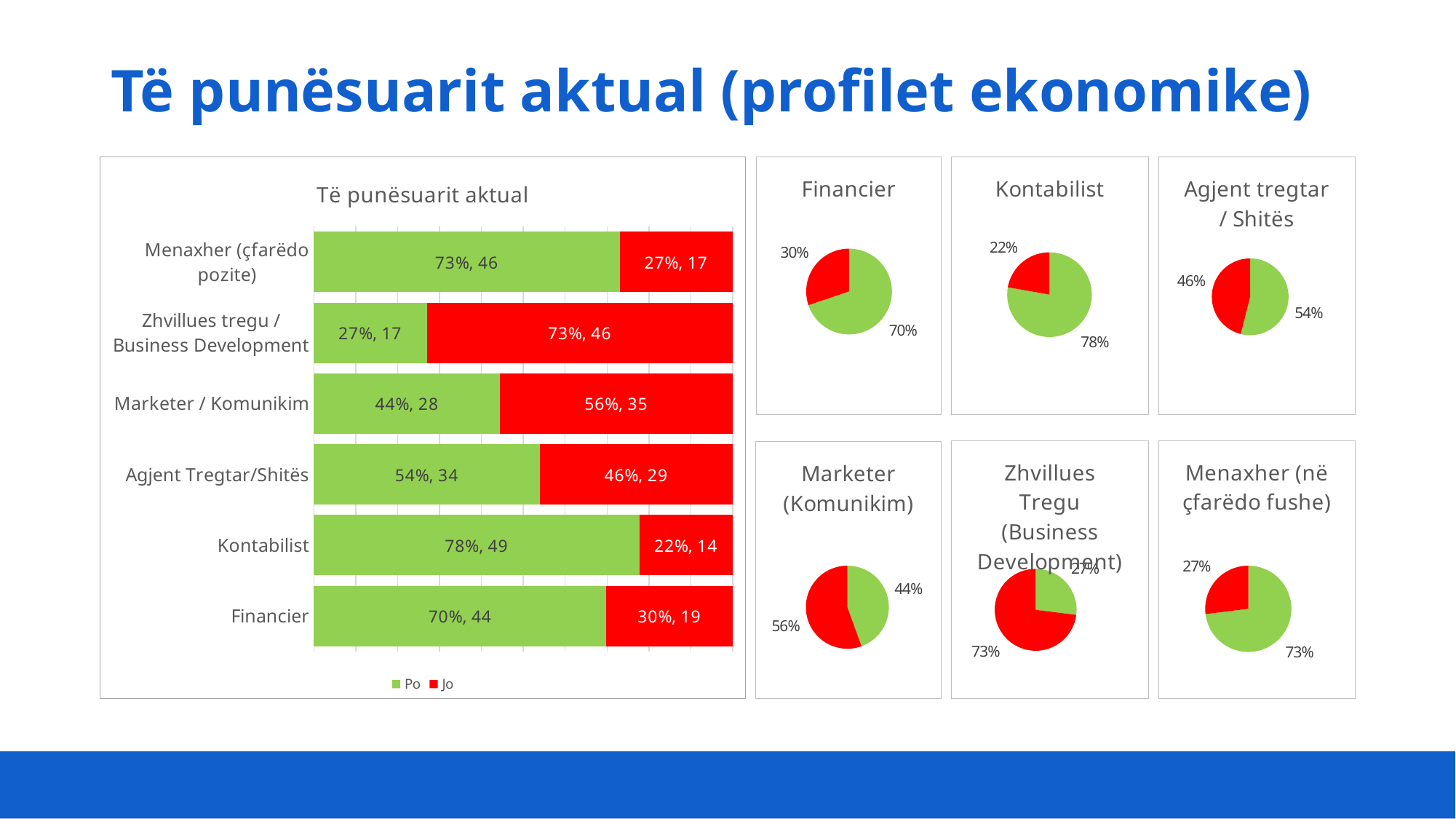
In the 'Të punësuarit aktual' bar chart, which category has the lowest Po percentage? Zhvillues tregu / Business Development In the 'Të punësuarit aktual' bar chart, is the Po count larger for Agjent Tregtar/Shitës or for Financier? Financier In the 'Të punësuarit aktual' bar chart, what is the data label for the Jo series for Financier? 30%, 19 How many categories are shown in the 'Të punësuarit aktual' bar chart? 6 How many series does the legend of the 'Të punësuarit aktual' bar chart list? 2 What type of chart is 'Të punësuarit aktual'? Stacked bar chart In the 'Të punësuarit aktual' bar chart, what is the total count of Po and Jo for Menaxher (çfarëdo pozite)? 63 In the 'Të punësuarit aktual' bar chart, what is the difference in count between Jo and Po for Marketer / Komunikim? 7 In the 'Të punësuarit aktual' bar chart, what is the data label for the Po series for Kontabilist? 78%, 49 In the 'Agjent tregtar / Shitës' pie chart, what share does the green slice represent? 54% In the 'Financier' pie chart, what share does the red slice represent? 30% In the 'Të punësuarit aktual' bar chart, which category has the highest Po percentage? Kontabilist